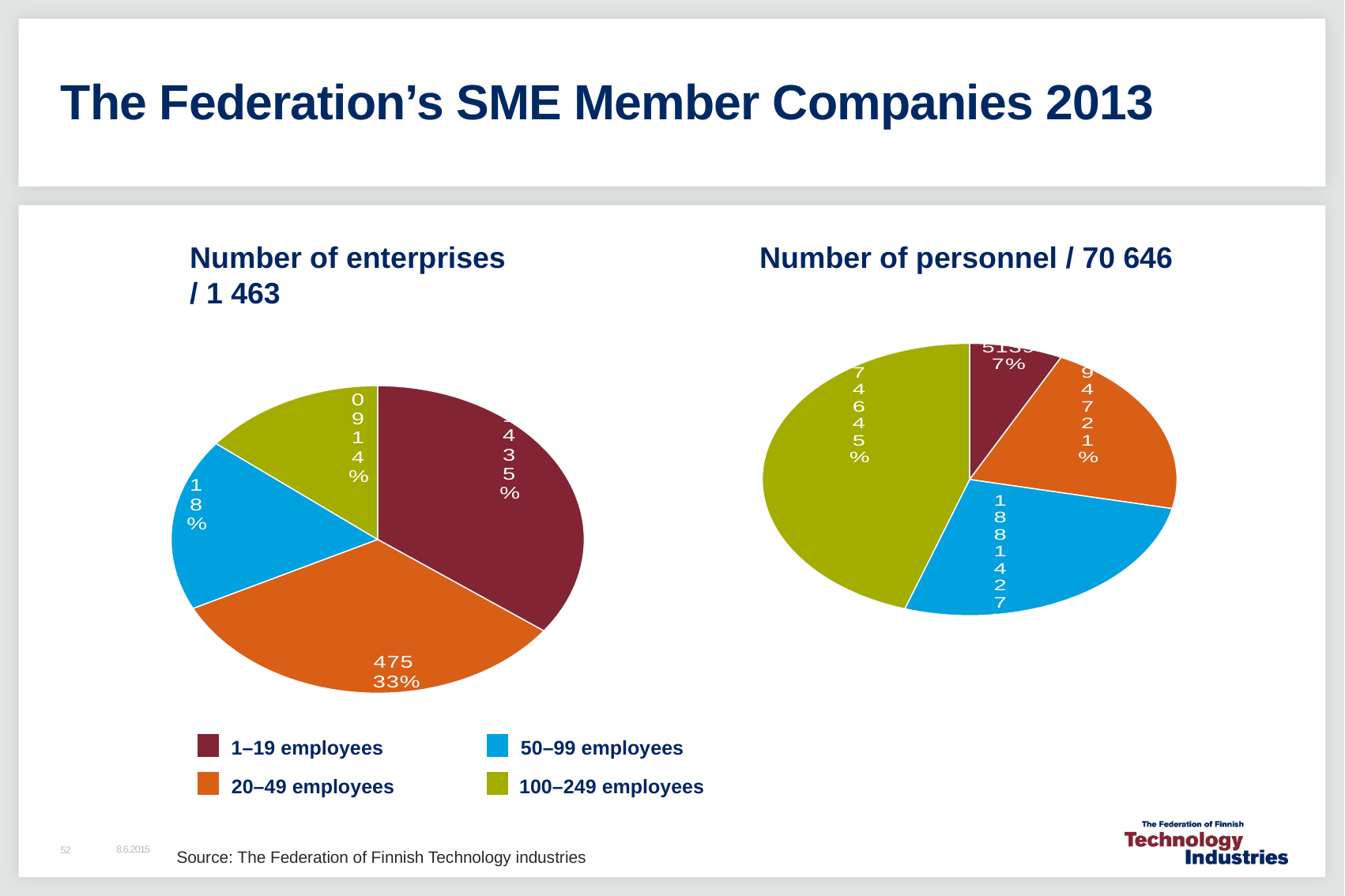
In the 'Number of enterprises' pie chart, how many enterprises have 20–49 employees? 475 How many categories does the legend list? 4 In the 'Number of enterprises' pie chart, what share of the pie is the 20–49 employees slice? 33% In the 'Number of personnel' pie chart, what share of the pie is the 100–249 employees slice? 45% In the 'Number of enterprises' pie chart, what share of the pie is the 1–19 employees slice? 35% In the 'Number of personnel' pie chart, which category has the largest slice? 100–249 employees What kind of charts are shown on the slide? Pie charts In the 'Number of personnel' pie chart, which category has the smallest slice? 1–19 employees In the 'Number of enterprises' pie chart, which is larger, the 50–99 employees slice or the 100–249 employees slice? 50–99 employees What total number of personnel is given in the title of the right-hand pie chart? 70 646 In the 'Number of enterprises' pie chart, which category has the smallest slice? 100–249 employees